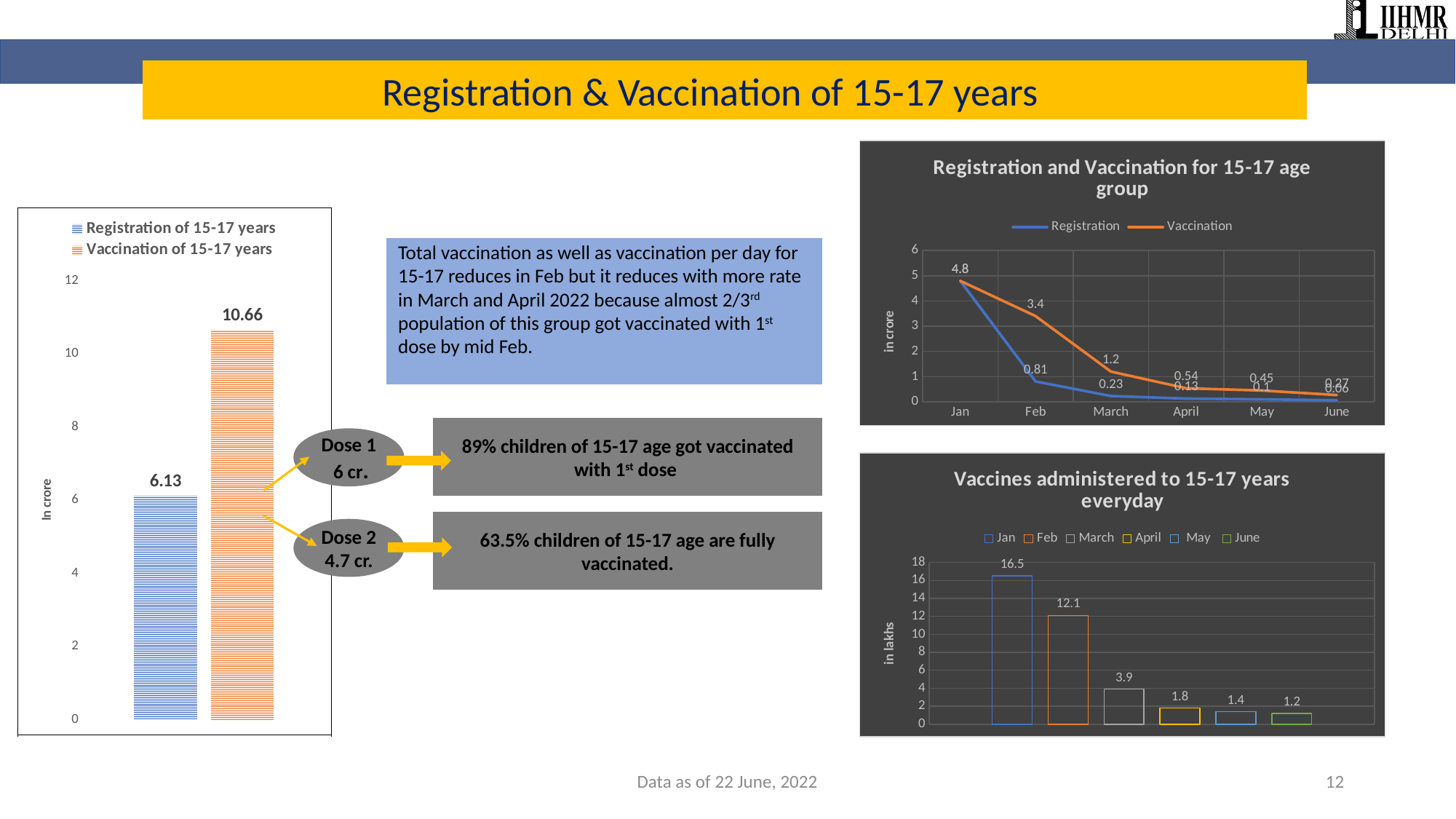
In the 'Vaccines administered to 15-17 years everyday' chart, which month has the highest value? Jan In the 'Registration and Vaccination for 15-17 age group' chart, what is the Registration value for Feb? 0.81 In the 'Vaccines administered to 15-17 years everyday' chart, what is the value for March? 3.9 In the left bar chart, what is the value for Registration of 15-17 years? 6.13 In the 'Registration and Vaccination for 15-17 age group' chart, do the Vaccination values rise or fall from Jan to June? Fall What kind of chart is 'Registration and Vaccination for 15-17 age group'? Line chart In the 'Registration and Vaccination for 15-17 age group' chart, how many series does the legend list? 2 In the left bar chart, what is the difference between Vaccination of 15-17 years and Registration of 15-17 years? 4.53 In the left bar chart, which is larger: Registration of 15-17 years or Vaccination of 15-17 years? Vaccination of 15-17 years In the 'Registration and Vaccination for 15-17 age group' chart, what is the Vaccination value for Feb? 3.4 In the 'Vaccines administered to 15-17 years everyday' chart, what is the difference between Jan and Feb? 4.4 In the left bar chart, what is the value for Vaccination of 15-17 years? 10.66